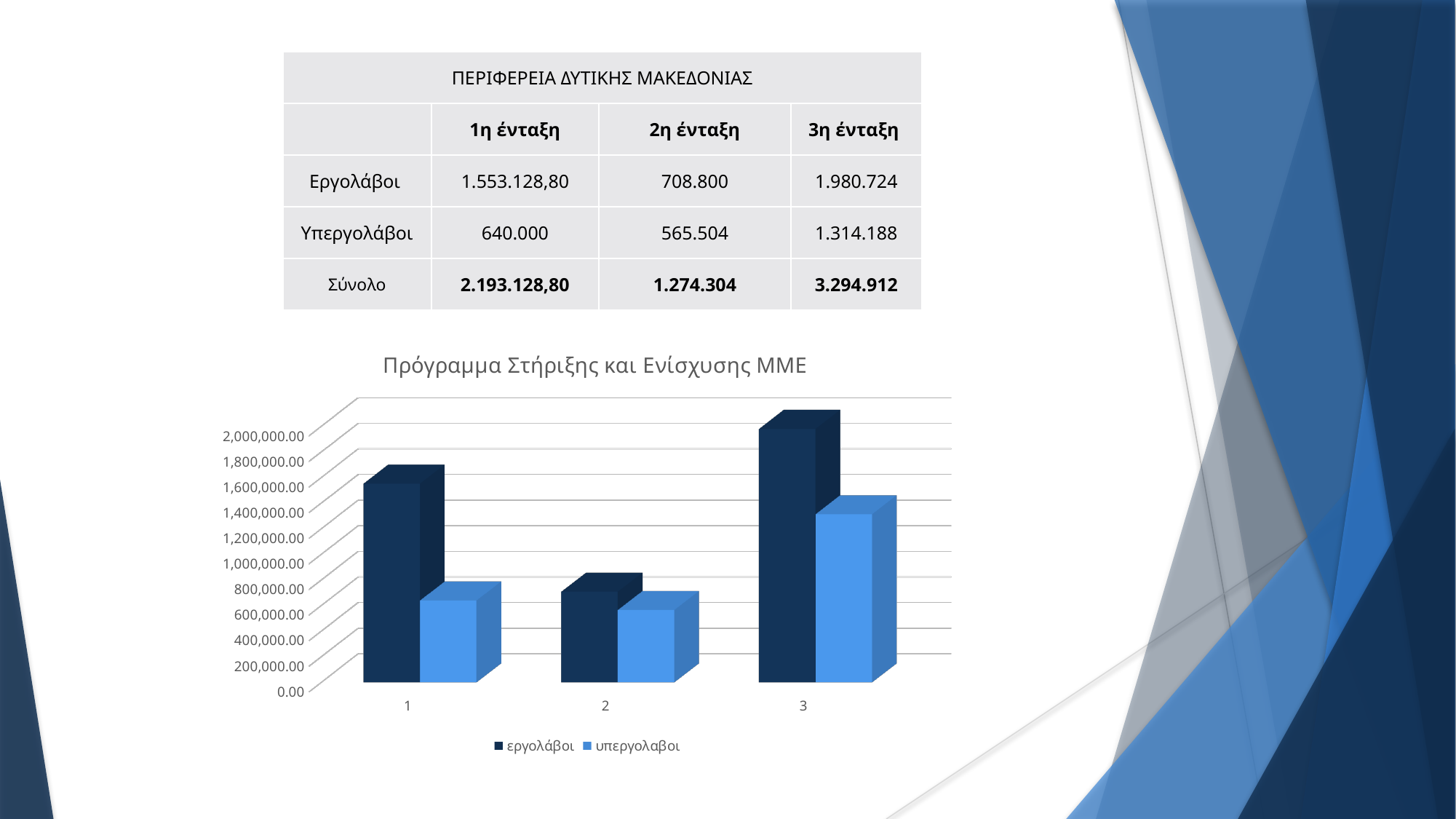
Which series is drawn in dark navy in the chart? εργολάβοι For which category is the υπεργολαβοι bar highest? 3 What kind of chart is shown on the slide? bar chart Is the εργολάβοι value for category 2 greater or less than 800,000.00? less How many series does the chart legend list? 2 Is the εργολάβοι value for category 3 greater or less than 1,800,000.00? greater In category 1, which series has the larger bar, εργολάβοι or υπεργολαβοι? εργολάβοι For which category is the εργολάβοι bar lowest? 2 What is the title of the chart? Πρόγραμμα Στήριξης και Ενίσχυσης ΜΜΕ For which category is the εργολάβοι bar highest? 3 Is the υπεργολαβοι value for category 3 greater or less than 1,200,000.00? greater How many categories are shown on the x axis of the chart? 3